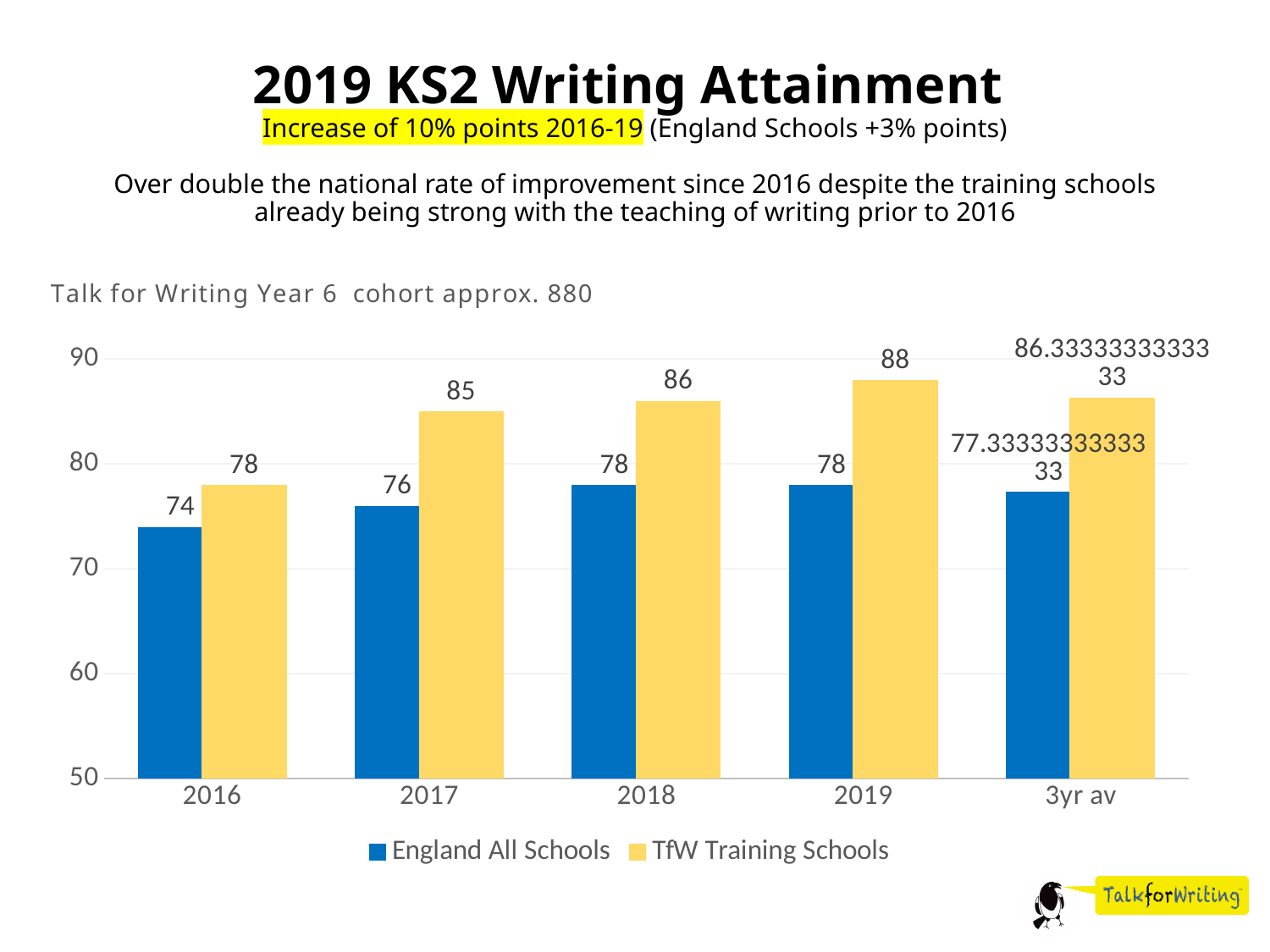
Which year has the lowest value for England All Schools? 2016 Which year has the highest value for TfW Training Schools? 2019 Do the values for TfW Training Schools rise or fall from 2016 to 2019? rise Is the value for TfW Training Schools in 2016 greater or less than 80? less What is the value for TfW Training Schools in 2017? 85 What is the difference between TfW Training Schools and England All Schools in 2018? 8 How many categories are shown on the x axis? 5 How many series does the legend list? 2 What kind of chart is shown on the slide? bar chart What is the value for England All Schools in 2016? 74 What is the value for TfW Training Schools in 2019? 88 Which is larger in 2017: England All Schools or TfW Training Schools? TfW Training Schools